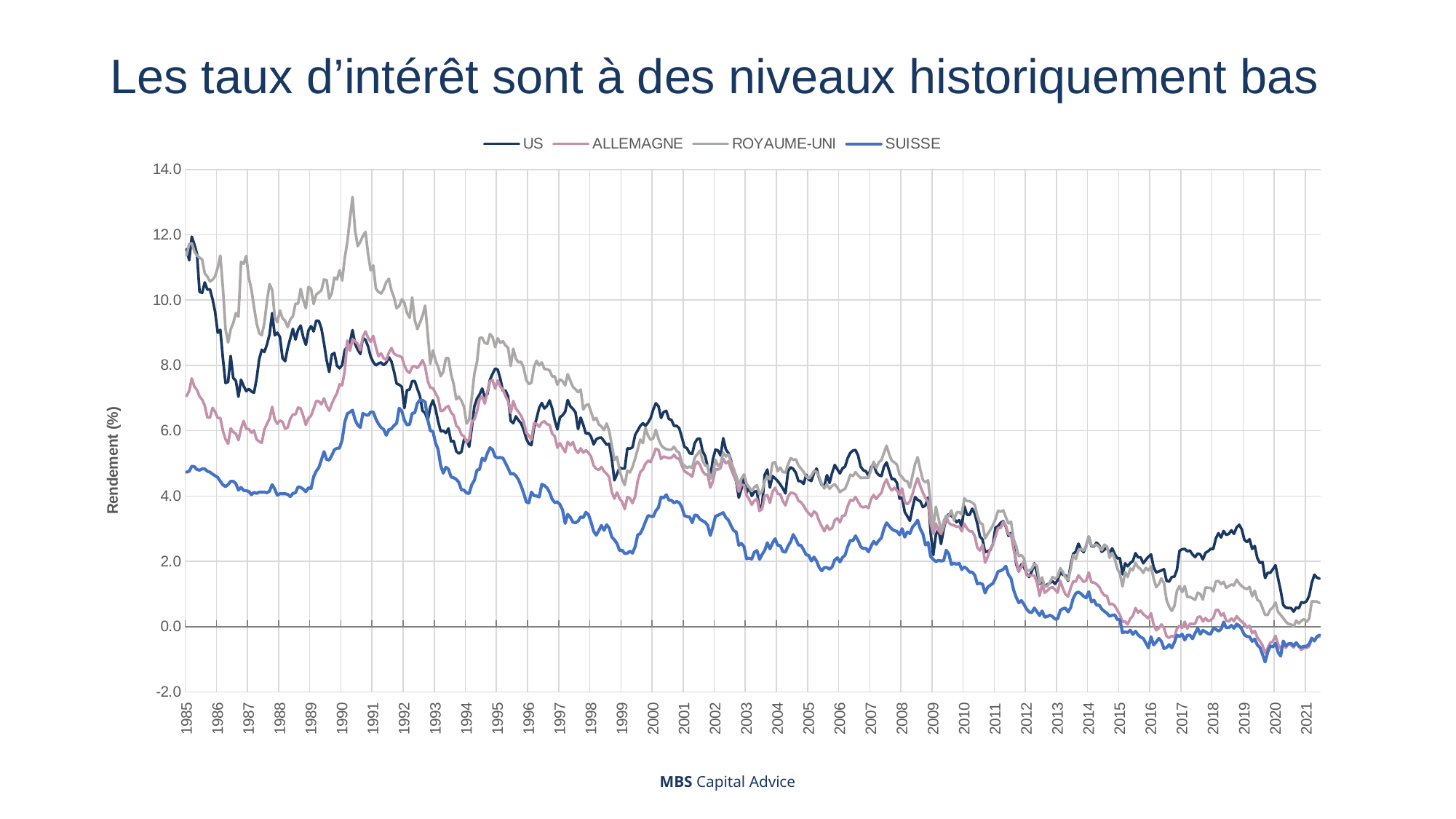
At the start of 1985, which is larger: the value for US or the value for SUISSE? US At the end of the chart in 2021, which is larger: the value for US or the value for SUISSE? US How many series does the legend list? 4 Is the value for SUISSE in 2016 greater or less than 0.0? less Which series reaches the lowest value anywhere on the chart? SUISSE Is the peak value for ROYAUME-UNI around 1990 greater or less than 12.0? greater Is the value for SUISSE at the start of 1985 greater or less than 4.0? greater What is the label of the vertical axis? Rendement (%) Overall, do the yields rise or fall from 1985 to 2021? fall Which series reaches the highest value anywhere on the chart? ROYAUME-UNI What kind of chart is shown on the slide? line chart